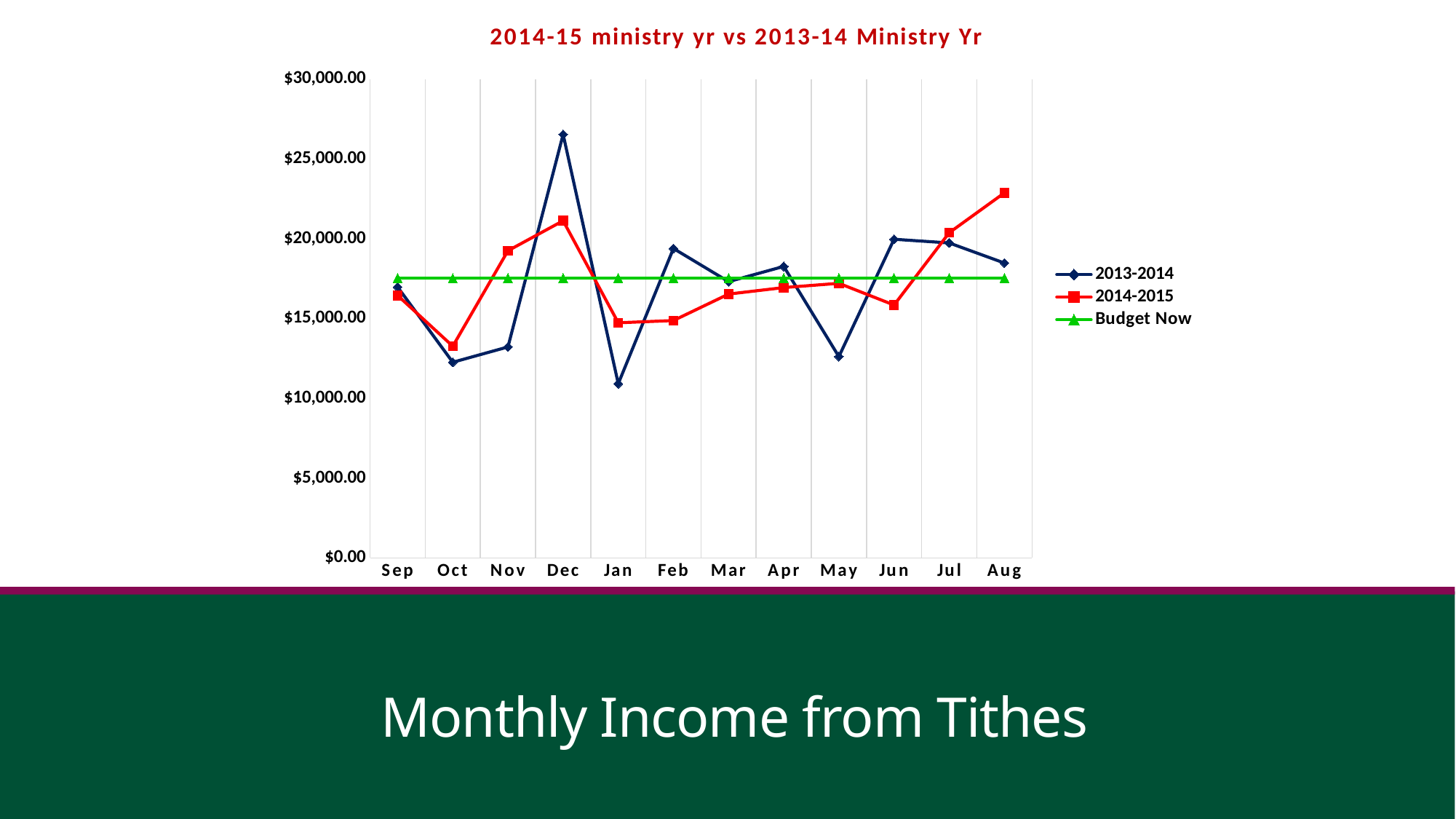
Is the 2013-2014 value for Jan greater or less than $15,000.00? less How many months are plotted along the x axis? 12 How many series does the legend list? 3 Is the 2013-2014 value for Dec greater or less than $25,000.00? greater In which month does the 2013-2014 series reach its highest value? Dec In which month does the 2014-2015 series reach its highest value? Aug What kind of chart is shown on the slide? line chart In which month does the 2013-2014 series reach its lowest value? Jan In Dec, which series has the larger value, 2013-2014 or 2014-2015? 2013-2014 Is the 2014-2015 value for Aug greater or less than $20,000.00? greater In which month does the 2014-2015 series reach its lowest value? Oct What is the title of the chart? 2014-15 ministry yr vs 2013-14 Ministry Yr